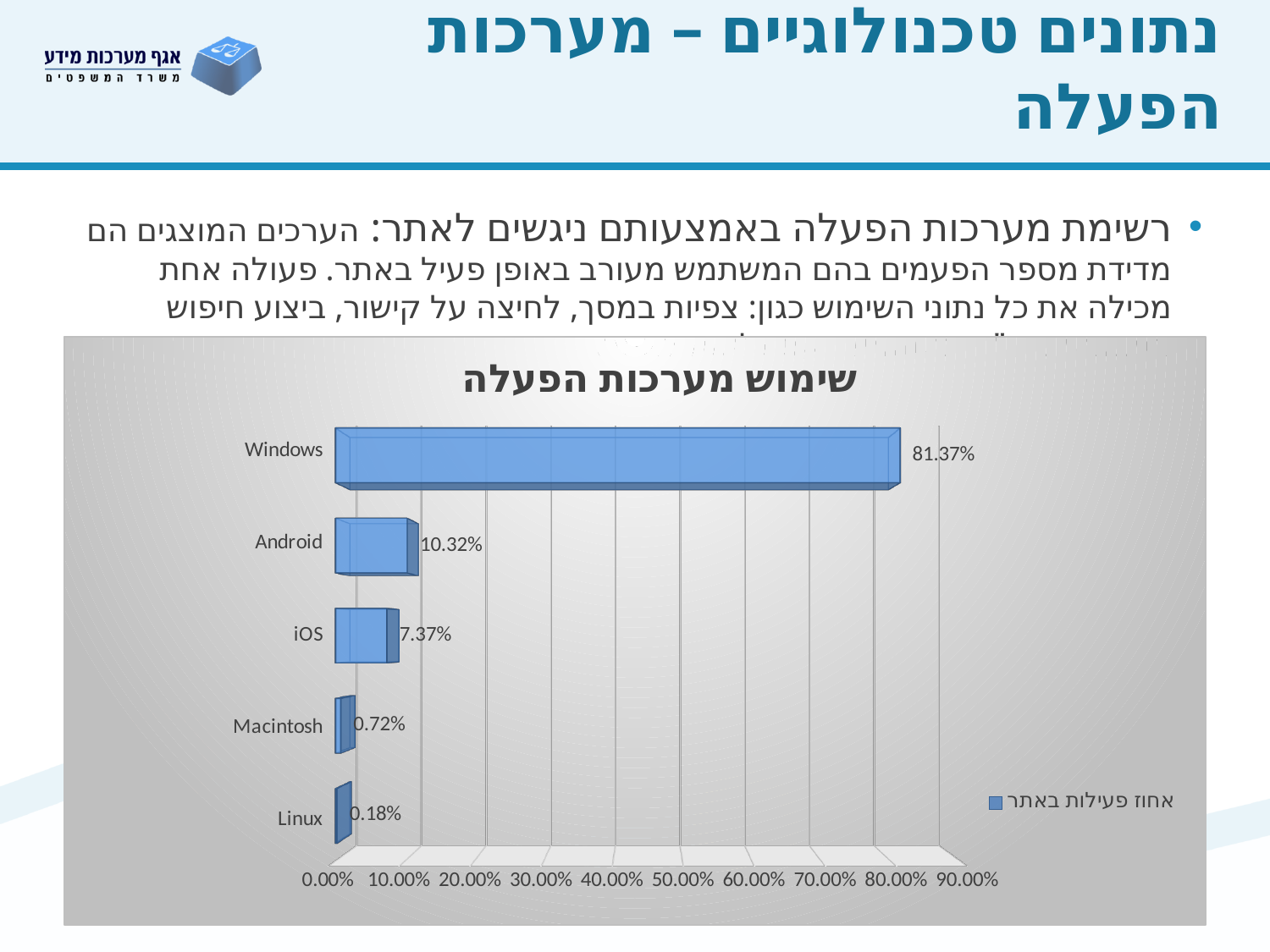
What is the value for Android? 10.32% What is the value for Linux? 0.18% Which operating system has the highest value? Windows What kind of chart is shown on the slide? Bar chart Which operating system has the lowest value? Linux What is the value for Windows? 81.37% How many operating systems are shown in the chart? 5 How many series does the legend list? 1 What is the value for Macintosh? 0.72% What is the value for iOS? 7.37% Which is larger, the value for Macintosh or the value for Linux? Macintosh What is the difference between the values for Android and iOS? 2.95%